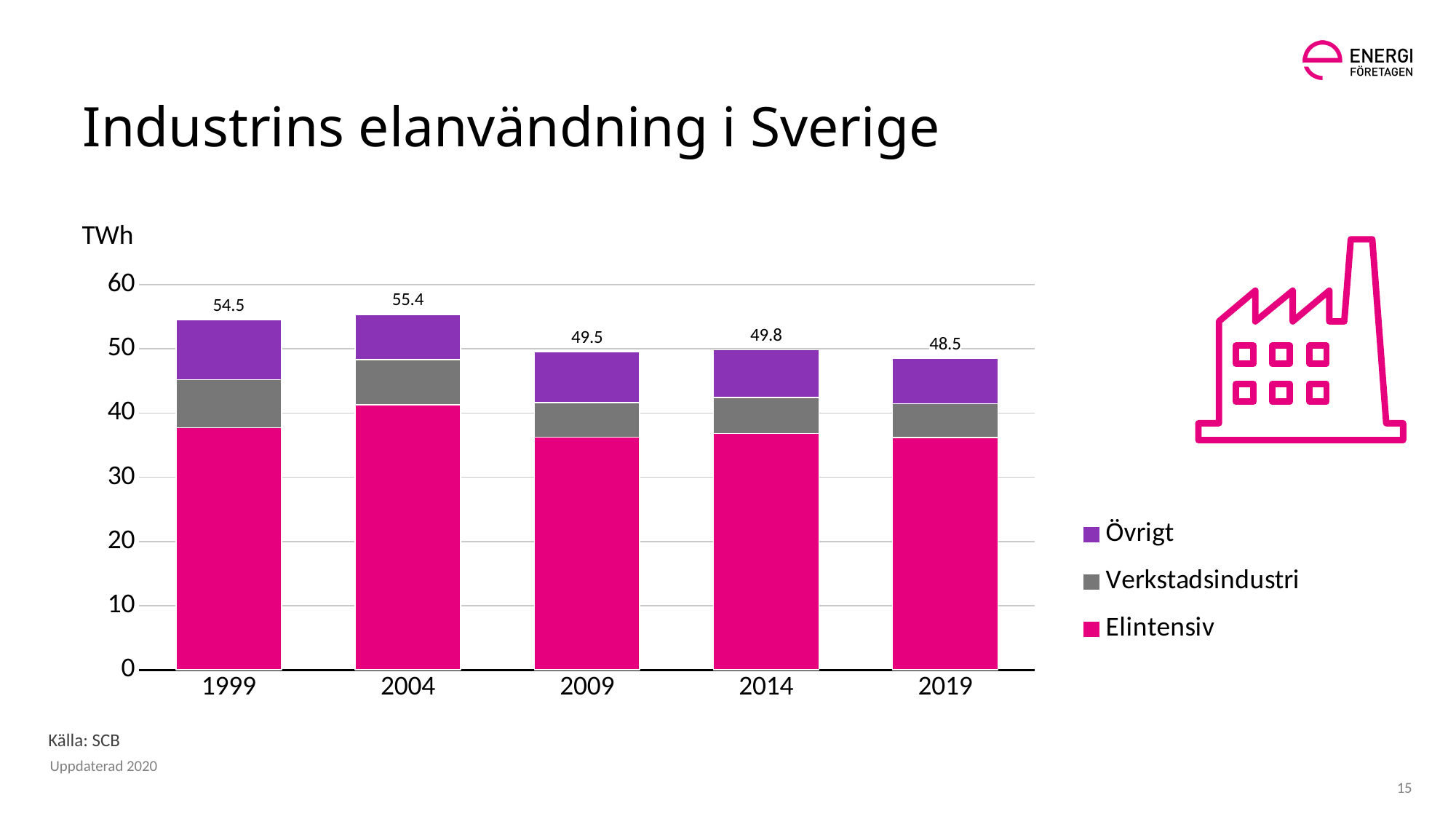
How many series does the legend list? 3 What is the total industrial electricity use shown for 1999? 54.5 Is the Elintensiv segment for 2004 greater or less than 40? greater What is the total value labelled above the 2019 bar? 48.5 Is the Elintensiv segment for 1999 greater or less than 40? less Which year has the lowest total bar? 2019 Which year has the highest total bar? 2004 By how much did the total fall from 1999 to 2019? 6.0 What unit is shown on the y axis of the chart? TWh Which total is larger, 2009 or 2014? 2014 How many years are shown on the x axis? 5 What is the difference between the total for 2004 and the total for 1999? 0.9